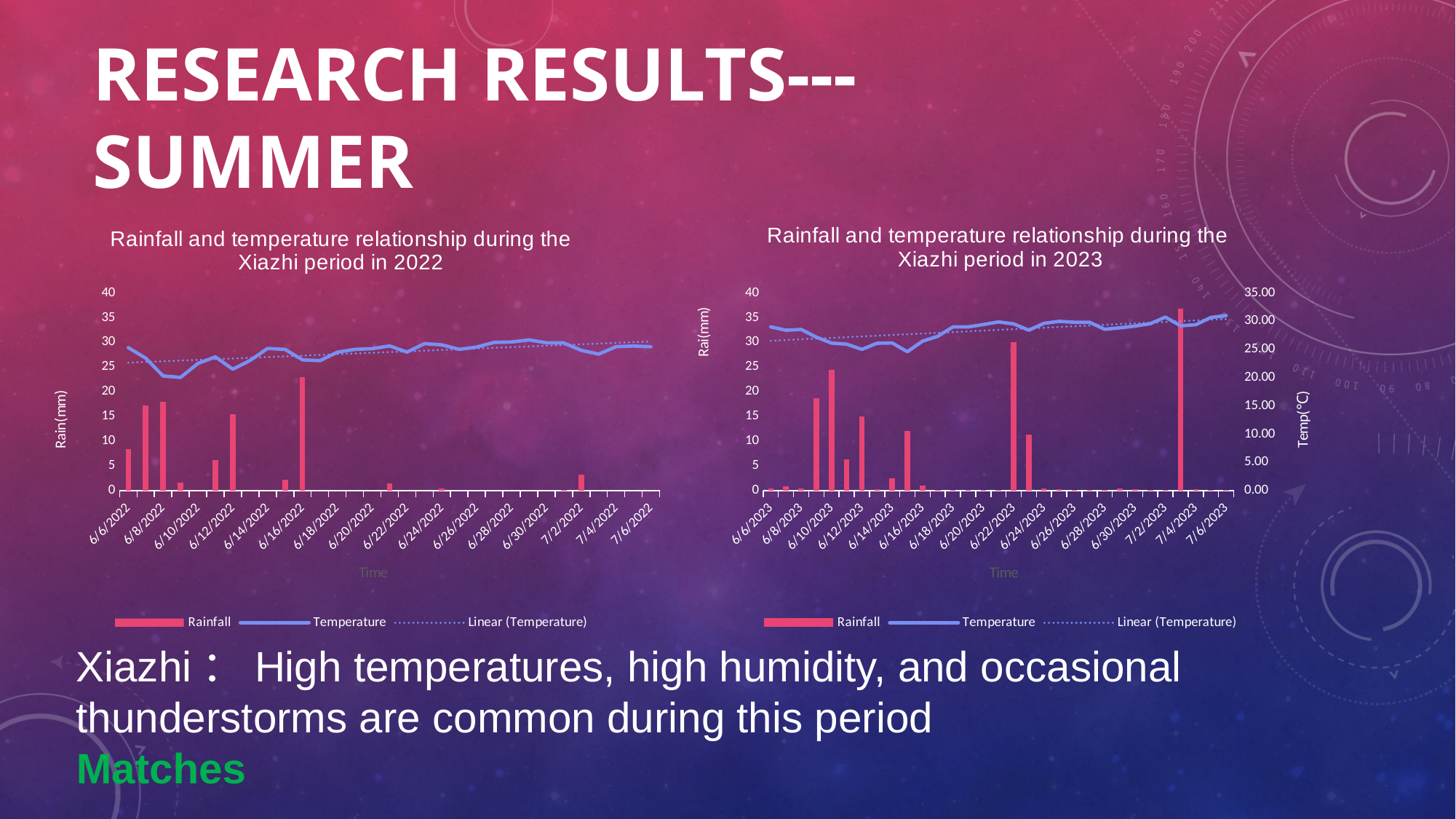
In the 2022 chart, which series is drawn as bars? Rainfall In the 2022 chart, is the rainfall value for 6/16/2022 greater or less than 20? greater In the 2022 chart, is the rainfall value for 6/6/2022 greater or less than 10? less In the 2023 chart, on which date is the rainfall bar highest? 7/3/2023 What kind of chart is the 'Rainfall and temperature relationship during the Xiazhi period in 2022' chart? A combined bar and line chart What is the title of the left chart? Rainfall and temperature relationship during the Xiazhi period in 2022 How many series does the legend of the 2023 chart list? 3 In the 2023 chart, does the Temperature line generally rise or fall from 6/6/2023 to 7/6/2023? rise In the 2023 chart, is the rainfall value for 6/10/2023 greater or less than 20? greater In the 2022 chart, which has the larger rainfall value, 6/12/2022 or 6/16/2022? 6/16/2022 In the 2022 chart, on which date is the rainfall bar highest? 6/16/2022